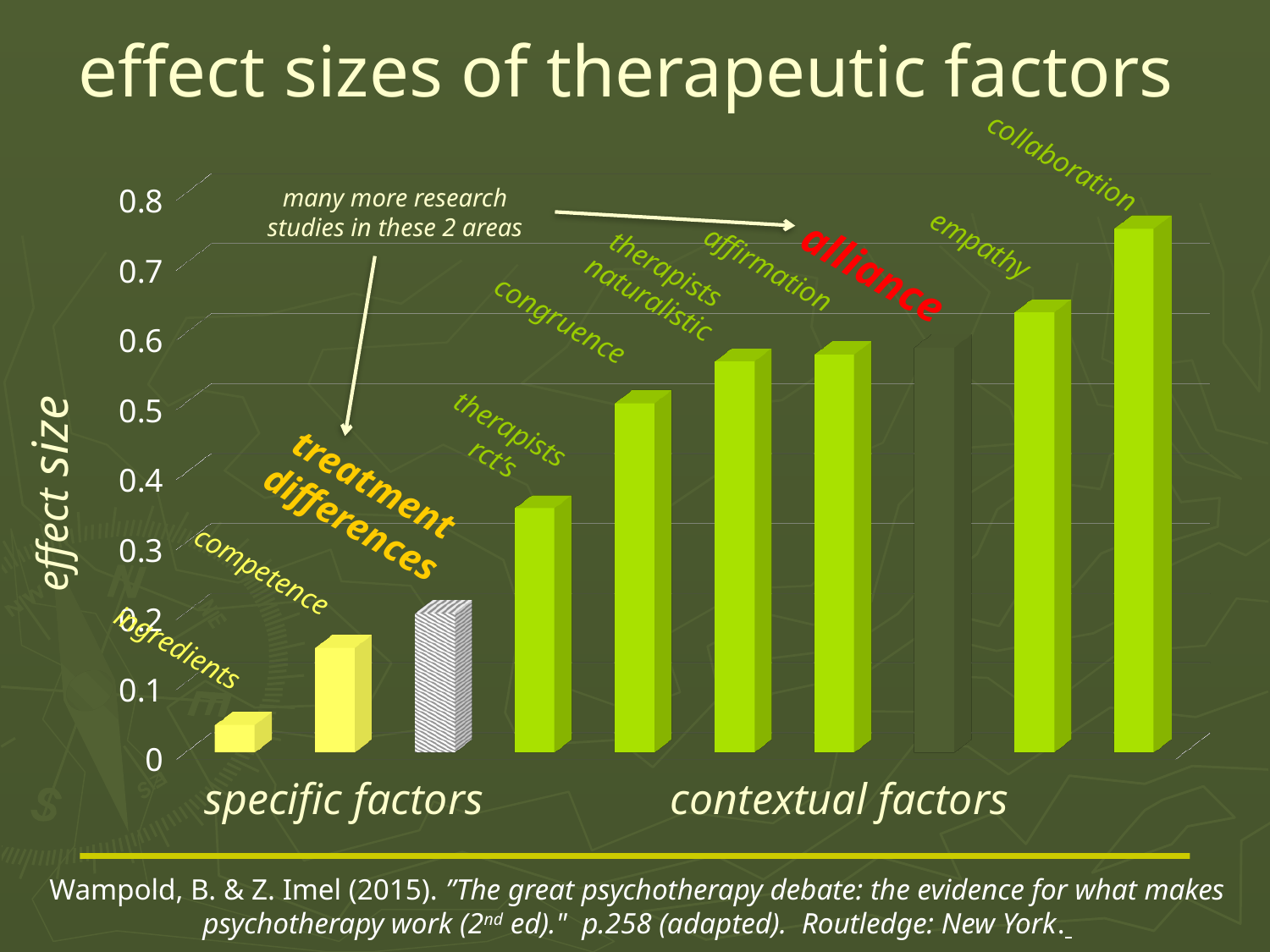
How many bars (therapeutic factors) are plotted in the chart? 10 Which therapeutic factor has the largest effect size in the chart? collaboration What kind of chart is shown on the slide? bar chart Is the effect size for collaboration greater or less than 0.7? greater Which has a larger effect size, therapists rct's or congruence? congruence Which therapeutic factor has the smallest effect size in the chart? ingredients Is the effect size for congruence greater or less than 0.4? greater Do the effect sizes rise or fall moving from left to right across the chart? rise What is the label on the vertical axis of the chart? effect size Is the effect size for therapists rct's greater or less than 0.4? less Which has a larger effect size, competence or collaboration? collaboration